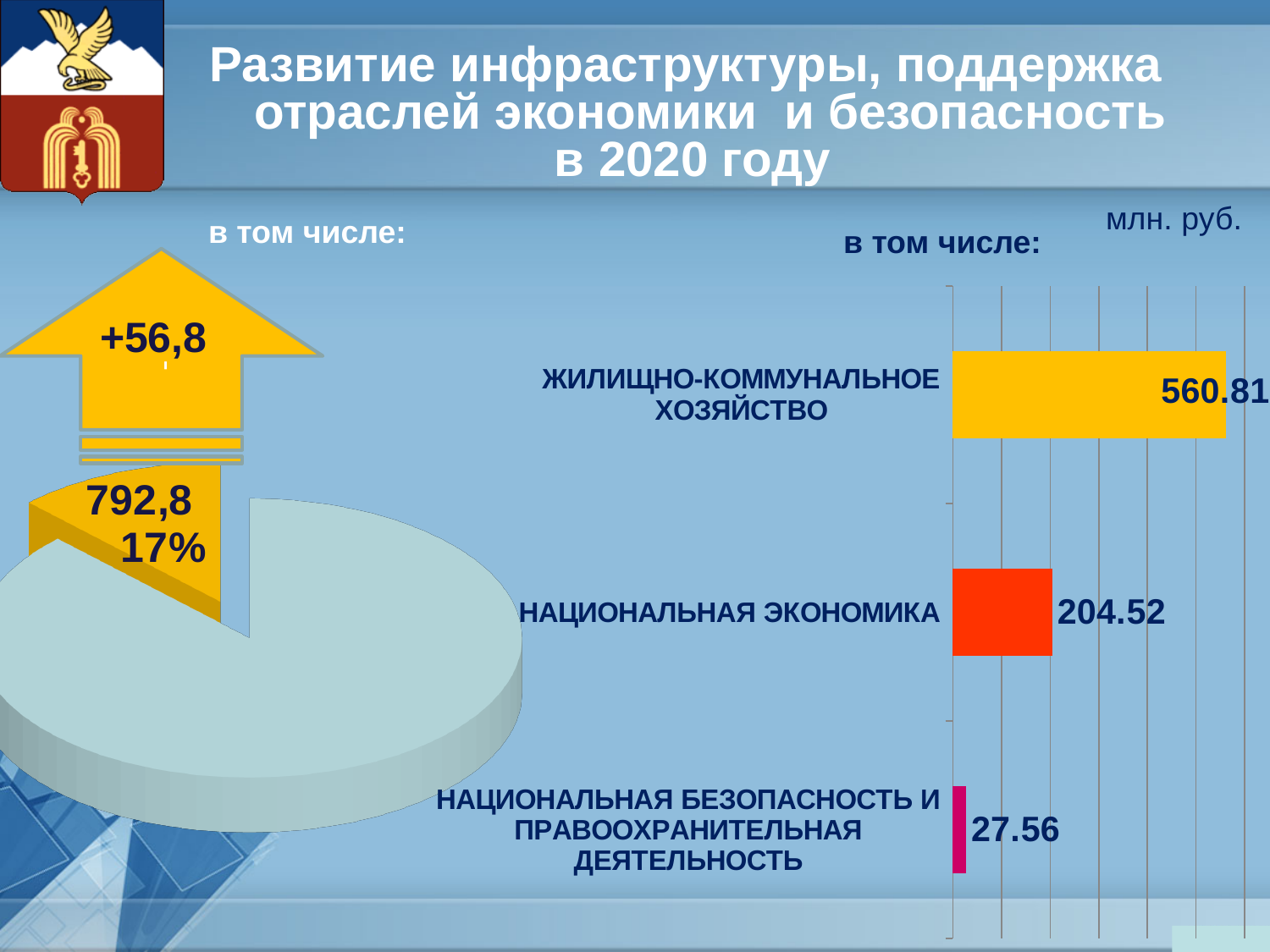
On the bar chart on the right, what is the difference between the values for НАЦИОНАЛЬНАЯ ЭКОНОМИКА and НАЦИОНАЛЬНАЯ БЕЗОПАСНОСТЬ И ПРАВООХРАНИТЕЛЬНАЯ ДЕЯТЕЛЬНОСТЬ? 176.96 On the bar chart on the right, which category has the lowest value? НАЦИОНАЛЬНАЯ БЕЗОПАСНОСТЬ И ПРАВООХРАНИТЕЛЬНАЯ ДЕЯТЕЛЬНОСТЬ On the pie chart on the left, what value is printed on the yellow slice? 792,8 On the pie chart on the left, what share of the pie does the labelled yellow slice represent? 17% On the bar chart on the right, what is the value for НАЦИОНАЛЬНАЯ БЕЗОПАСНОСТЬ И ПРАВООХРАНИТЕЛЬНАЯ ДЕЯТЕЛЬНОСТЬ? 27.56 On the bar chart on the right, which is larger: the value for НАЦИОНАЛЬНАЯ ЭКОНОМИКА or the value for НАЦИОНАЛЬНАЯ БЕЗОПАСНОСТЬ И ПРАВООХРАНИТЕЛЬНАЯ ДЕЯТЕЛЬНОСТЬ? НАЦИОНАЛЬНАЯ ЭКОНОМИКА What kind of chart is the chart on the right side of the slide? Bar chart On the bar chart on the right, what is the difference between the values for ЖИЛИЩНО-КОММУНАЛЬНОЕ ХОЗЯЙСТВО and НАЦИОНАЛЬНАЯ ЭКОНОМИКА? 356.29 On the bar chart on the right, which category has the highest value? ЖИЛИЩНО-КОММУНАЛЬНОЕ ХОЗЯЙСТВО How many categories are shown on the bar chart on the right? 3 On the bar chart on the right, what is the value for ЖИЛИЩНО-КОММУНАЛЬНОЕ ХОЗЯЙСТВО? 560.81 On the bar chart on the right, what is the value for НАЦИОНАЛЬНАЯ ЭКОНОМИКА? 204.52